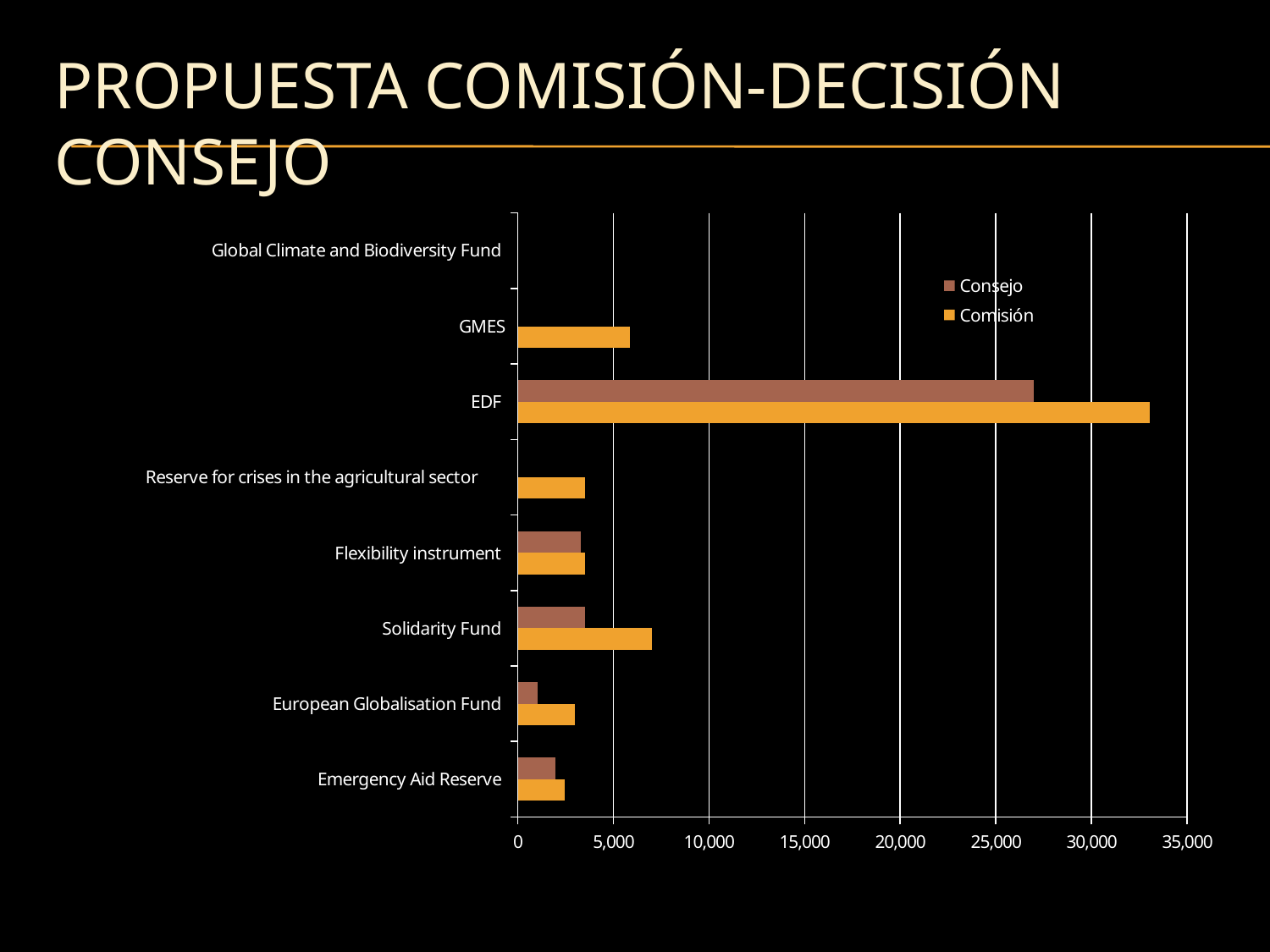
Which category has the highest Consejo value? EDF Is the Comisión value for GMES greater or less than 5,000? greater What kind of chart is shown on the slide? bar chart For EDF, which is larger, the Comisión value or the Consejo value? Comisión How many series does the legend list? 2 Is the Consejo value for EDF greater or less than 25,000? greater How many categories are shown on the vertical axis of the chart? 8 What are the two series named in the legend? Consejo and Comisión Is the Comisión value for EDF greater or less than 30,000? greater Which category has the highest Comisión value? EDF Which has the larger Comisión value, Solidarity Fund or Flexibility instrument? Solidarity Fund